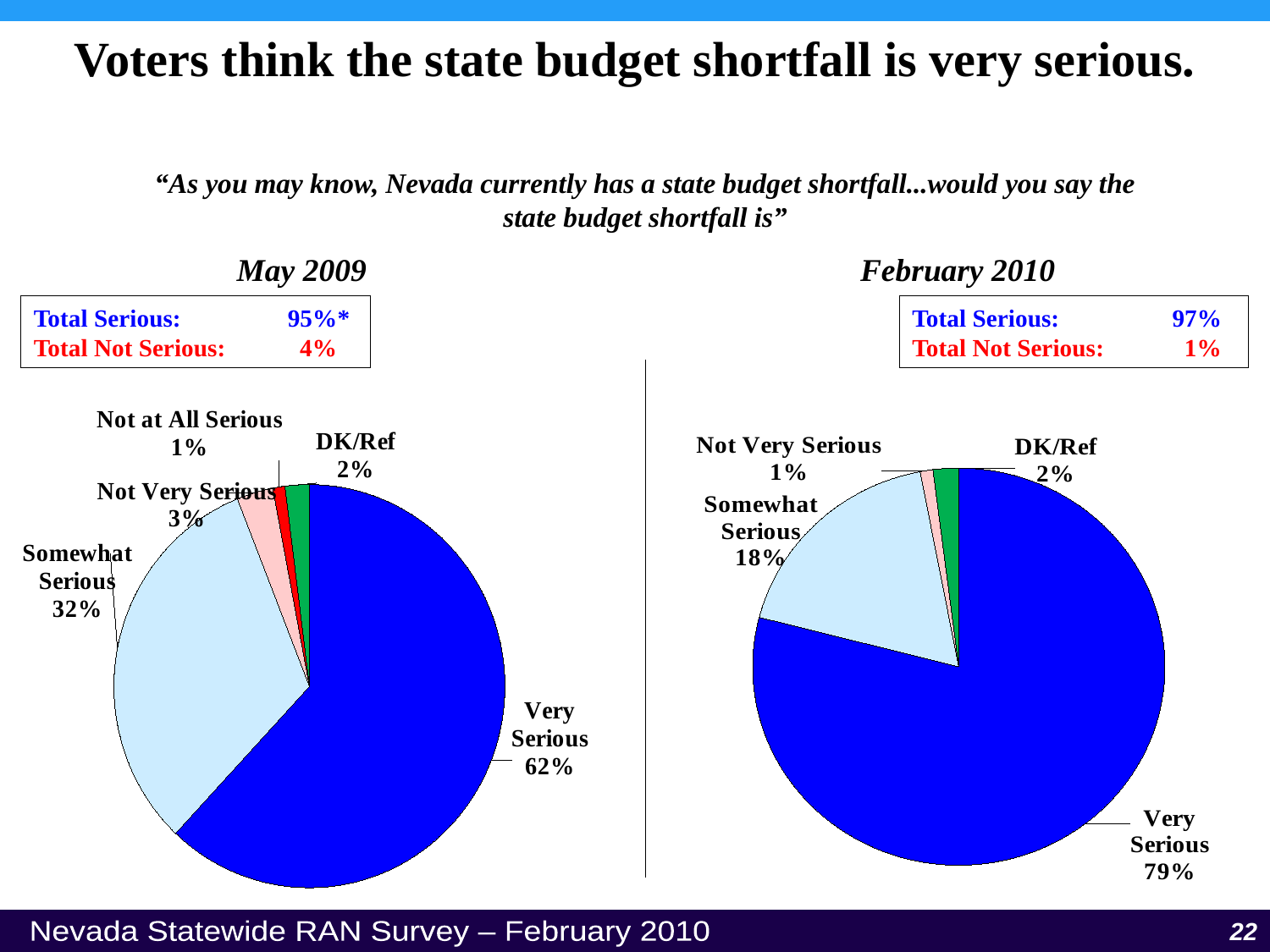
How many slices does the May 2009 pie chart have? 5 In the February 2010 chart, what percentage of voters said the shortfall is Somewhat Serious? 18% In the February 2010 chart, what percentage is labelled DK/Ref? 2% How many slices does the February 2010 pie chart have? 4 In the May 2009 chart, which category has the smallest slice? Not at All Serious In the May 2009 chart, what is the difference between the Somewhat Serious and Not Very Serious slices? 29% Which is larger: the Somewhat Serious slice in May 2009 or the Somewhat Serious slice in February 2010? May 2009 In the May 2009 chart, what percentage of voters said the shortfall is Very Serious? 62% In the May 2009 chart, which category has the largest slice? Very Serious What is the Total Serious figure shown for February 2010? 97% What type of chart is used on this slide? Pie chart What is the difference between the Very Serious share in February 2010 and the Very Serious share in May 2009? 17%